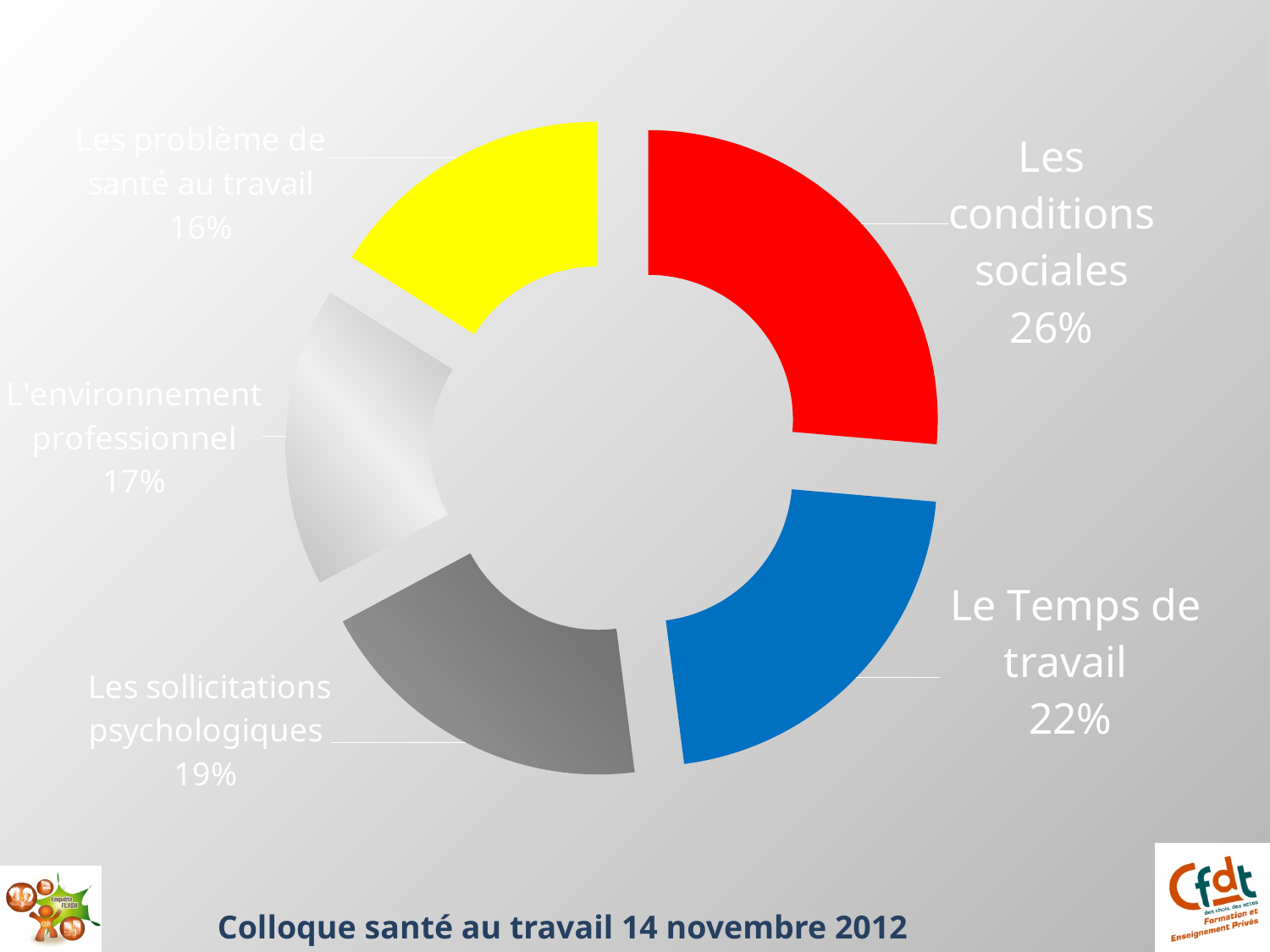
What percentage is shown for "L'environnement professionnel"? 17% What percentage is shown for "Les conditions sociales"? 26% What percentage is shown for "Les problème de santé au travail"? 16% Which category has the smallest share of the chart? Les problème de santé au travail What percentage is shown for "Le Temps de travail"? 22% Which is larger: the share for "Les sollicitations psychologiques" or the share for "L'environnement professionnel"? Les sollicitations psychologiques Which category has the largest share of the chart? Les conditions sociales What percentage is shown for "Les sollicitations psychologiques"? 19% What is the difference in percentage points between "Les conditions sociales" and "Le Temps de travail"? 4 How many categories are shown in the chart? 5 What colour is the segment for "Le Temps de travail"? Blue What kind of chart is shown on the slide? Doughnut (pie) chart